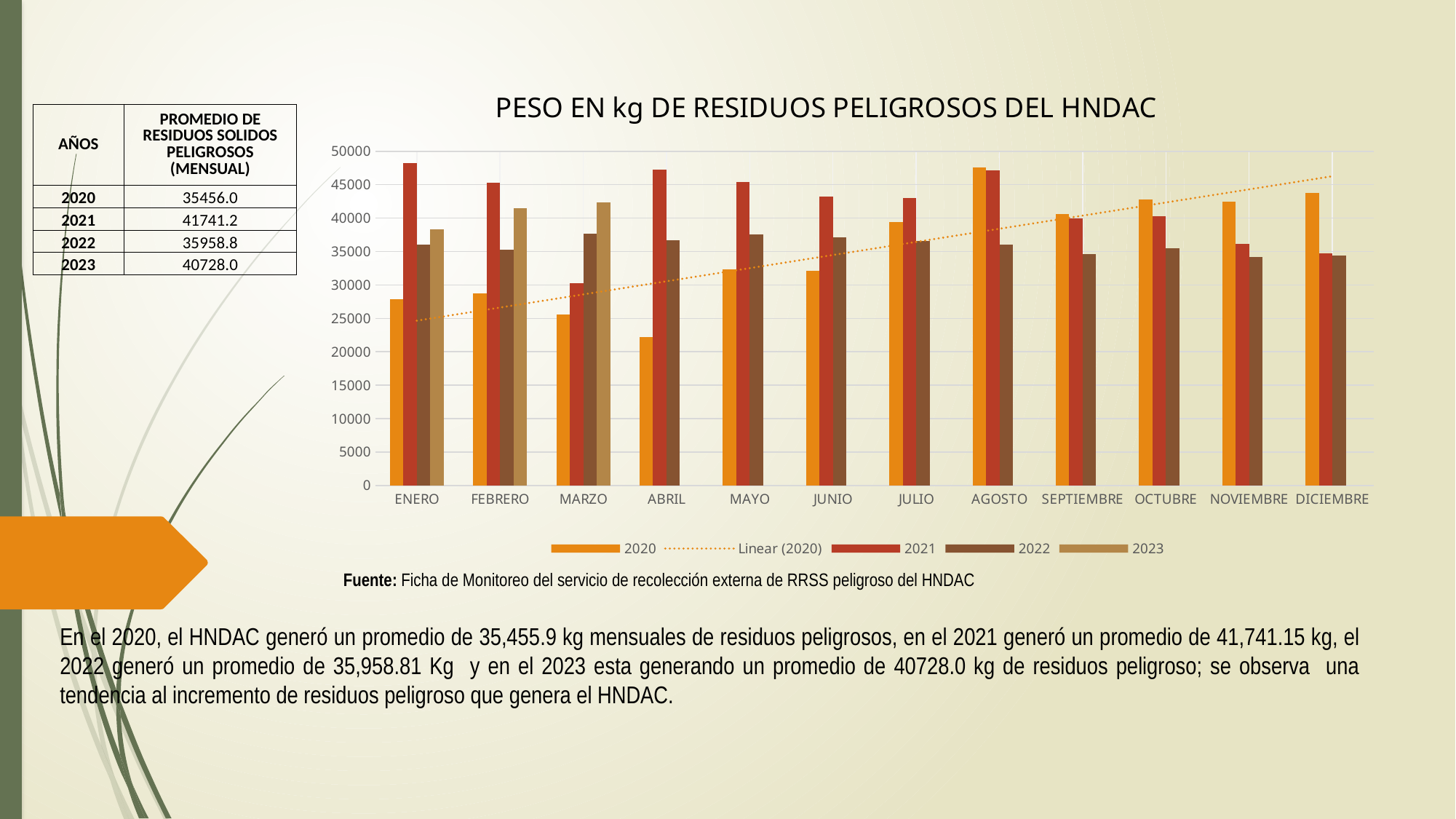
In which month is the 2020 bar the lowest? ABRIL In which month is the 2021 bar the lowest? MARZO How many entries does the chart legend list? 5 Is the value for 2020 in ENERO greater or less than 30000? less Does the Linear (2020) trend line rise or fall from ENERO to DICIEMBRE? Rises How many months (categories) are shown on the x axis of the chart? 12 In ABRIL, which is larger: the 2020 bar or the 2022 bar? 2022 What is the title of the chart? PESO EN kg DE RESIDUOS PELIGROSOS DEL HNDAC Is the value for 2021 in ENERO greater or less than 45000? greater What type of chart is shown on the slide? Bar chart In which month is the 2020 bar the highest? AGOSTO Is the value for 2023 in MARZO greater or less than 40000? greater